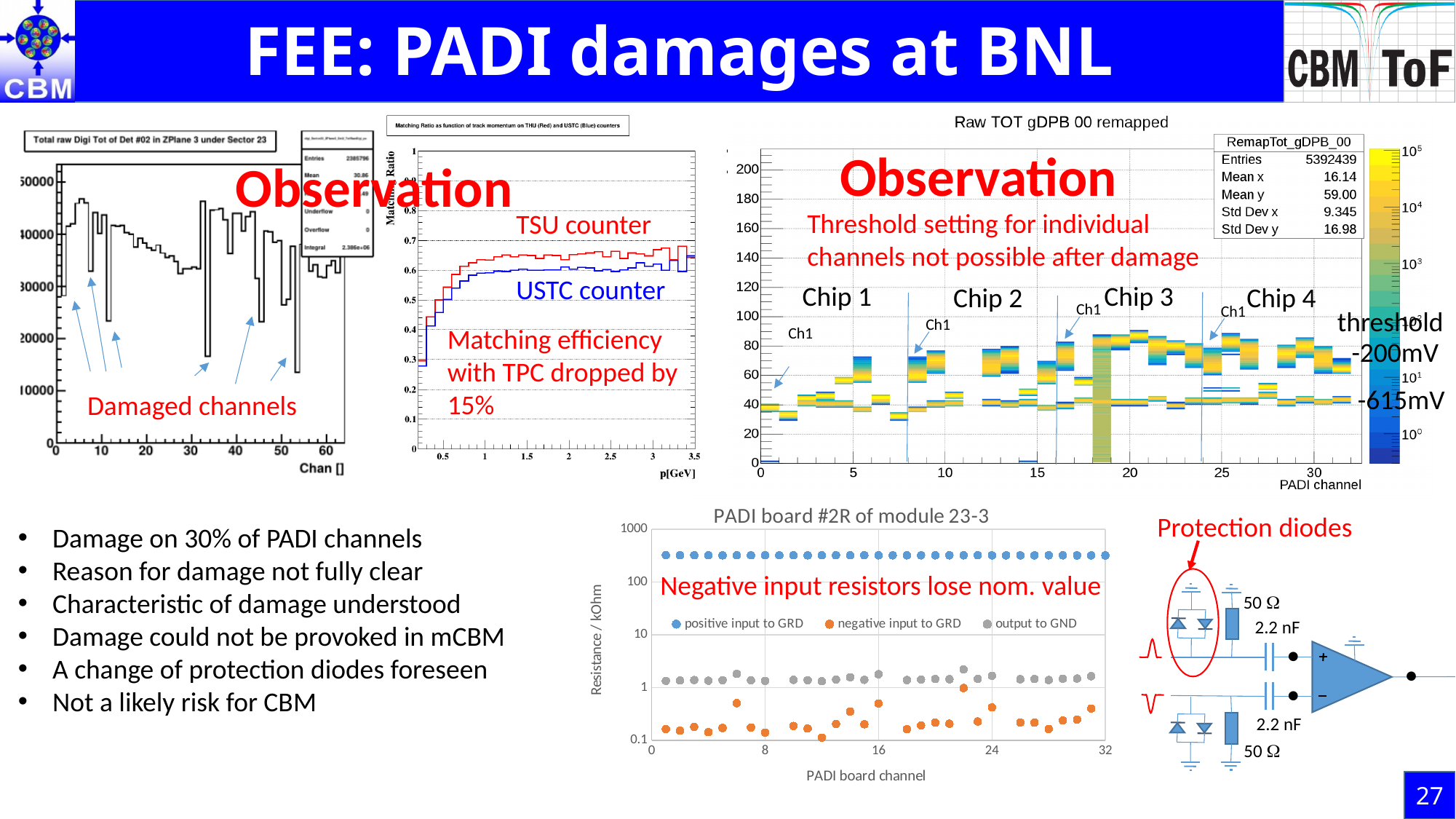
How many series does the legend of "PADI board #2R of module 23-3" list? 3 In "PADI board #2R of module 23-3", is the resistance for "negative input to GRD" at channel 1 greater or less than 1? less In "PADI board #2R of module 23-3", is the resistance for "positive input to GRD" at channel 8 greater or less than 100? greater In "Total raw Digi Tot of Det #02 in ZPlane 3 under Sector 23", what is the Mean value shown in the statistics box? 30.86 What is the x-axis label of "PADI board #2R of module 23-3"? PADI board channel In "Raw TOT gDPB 00 remapped", what is the Mean x value in the statistics box? 16.14 In "PADI board #2R of module 23-3", which series is plotted in orange? negative input to GRD What kind of chart is "PADI board #2R of module 23-3"? scatter chart In the matching ratio chart (top middle), which series is higher at p = 2 GeV: TSU counter or USTC counter? TSU counter In "Raw TOT gDPB 00 remapped", how many entries does the statistics box report? 5392439 In "PADI board #2R of module 23-3", which series has the larger resistance at channel 16: "positive input to GRD" or "negative input to GRD"? positive input to GRD In the matching ratio chart (top middle), does the matching ratio rise or fall as p increases from 0.2 to 1 GeV? rise